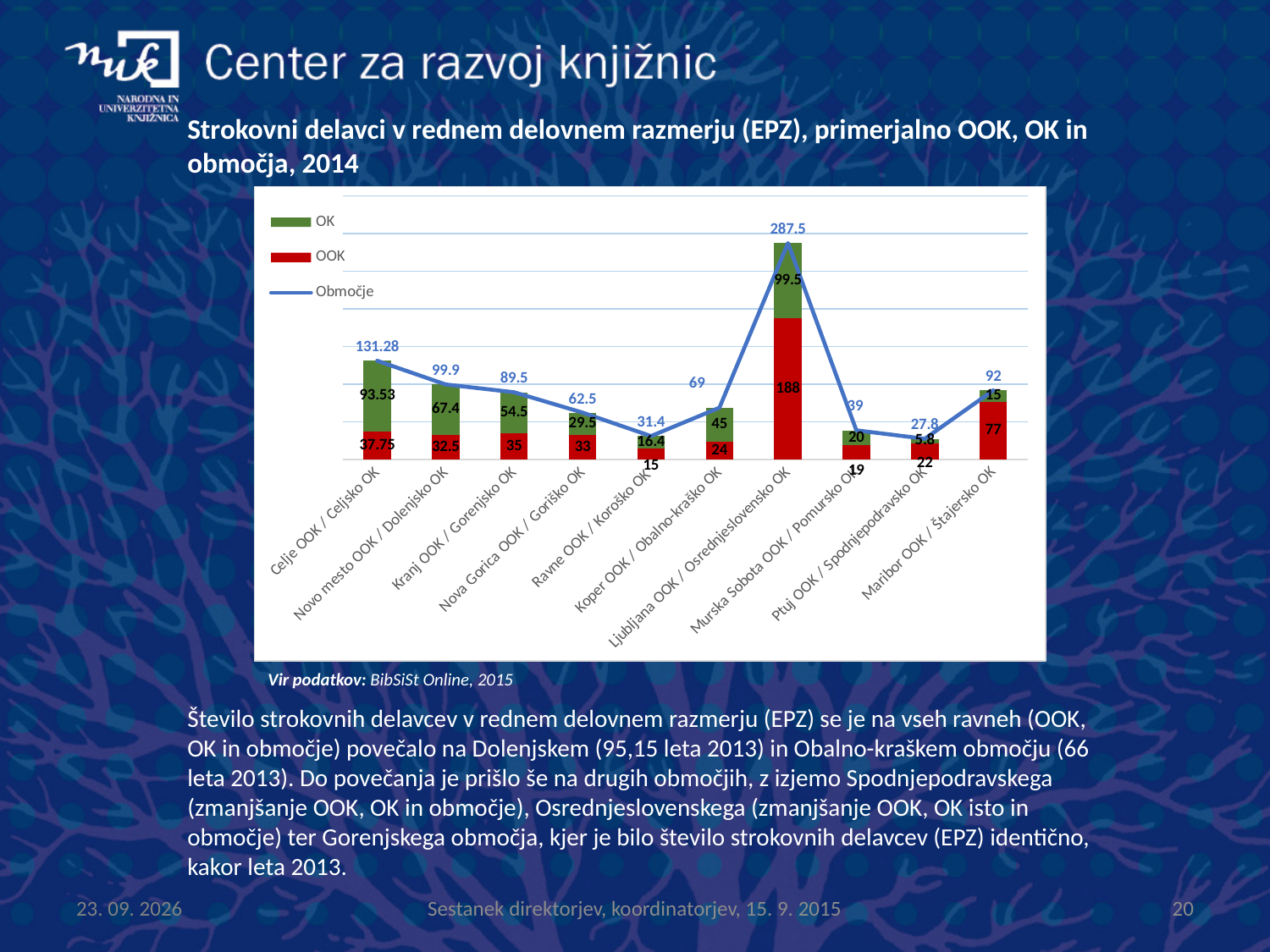
Which series is drawn as a line rather than bars? Območje What is the OK value for Celje OOK / Celjsko OK? 93.53 How many series does the legend list? 3 What is the OOK value for Ljubljana OOK / Osrednjeslovensko OK? 188 Which category has the highest Območje value? Ljubljana OOK / Osrednjeslovensko OK What kind of chart is this? Combined stacked bar and line chart Which category has the lowest Območje value? Ptuj OOK / Spodnjepodravsko OK Which is larger, the OOK value for Maribor OOK / Štajersko OK or the OOK value for Celje OOK / Celjsko OK? Maribor OOK / Štajersko OK What is the Območje value for Novo mesto OOK / Dolenjsko OK? 99.9 What is the OK value for Ptuj OOK / Spodnjepodravsko OK? 5.8 What is the difference between the Območje values for Celje OOK / Celjsko OK and Maribor OOK / Štajersko OK? 39.28 How many categories are shown on the x axis? 10